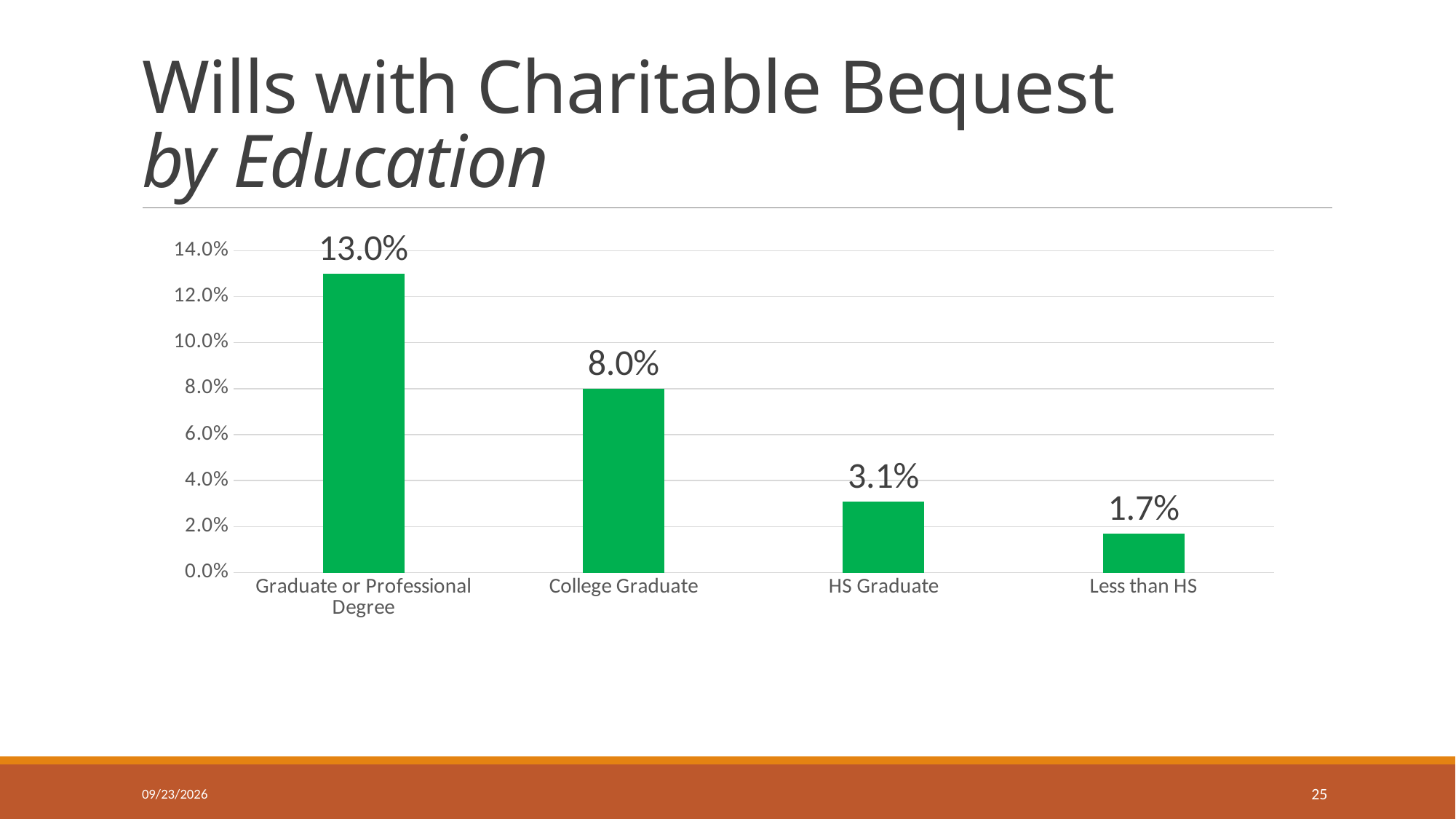
Do the values rise or fall moving from left to right along the x axis? fall What is the difference between the values for HS Graduate and Less than HS? 1.4% Which education category has the highest value? Graduate or Professional Degree What is the value for HS Graduate? 3.1% Is the value for Graduate or Professional Degree greater or less than 12.0%? greater What is the value for College Graduate? 8.0% What is the difference between the values for Graduate or Professional Degree and College Graduate? 5.0% How many education categories are shown in the chart? 4 What is the value for Less than HS? 1.7% Which education category has the lowest value? Less than HS Which is larger, the value for College Graduate or the value for HS Graduate? College Graduate What kind of chart is shown on the slide? bar chart